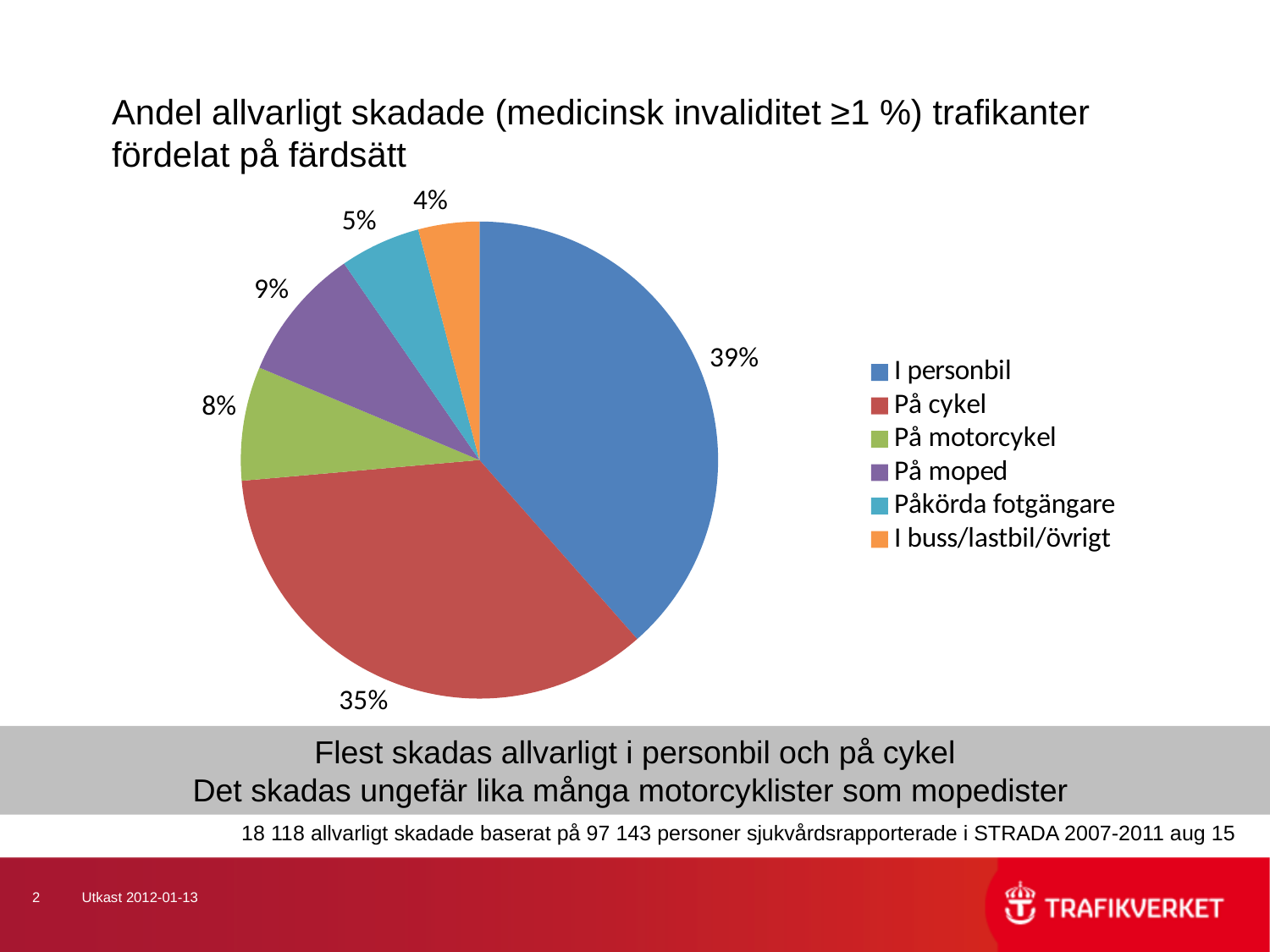
How many categories does the legend list? 6 Which category has the largest share of the pie? I personbil What share of the pie does "På cykel" represent? 35% What is the value shown for "I buss/lastbil/övrigt"? 4% What share of the pie does "I personbil" represent? 39% What is the value shown for "På moped"? 9% What kind of chart is shown on the slide? Pie chart What is the difference in percentage points between "I personbil" and "På cykel"? 4 Which category has the smallest share of the pie? I buss/lastbil/övrigt What is the value shown for "På motorcykel"? 8% Which is larger, the share for "På moped" or the share for "På motorcykel"? På moped What is the value shown for "Påkörda fotgängare"? 5%